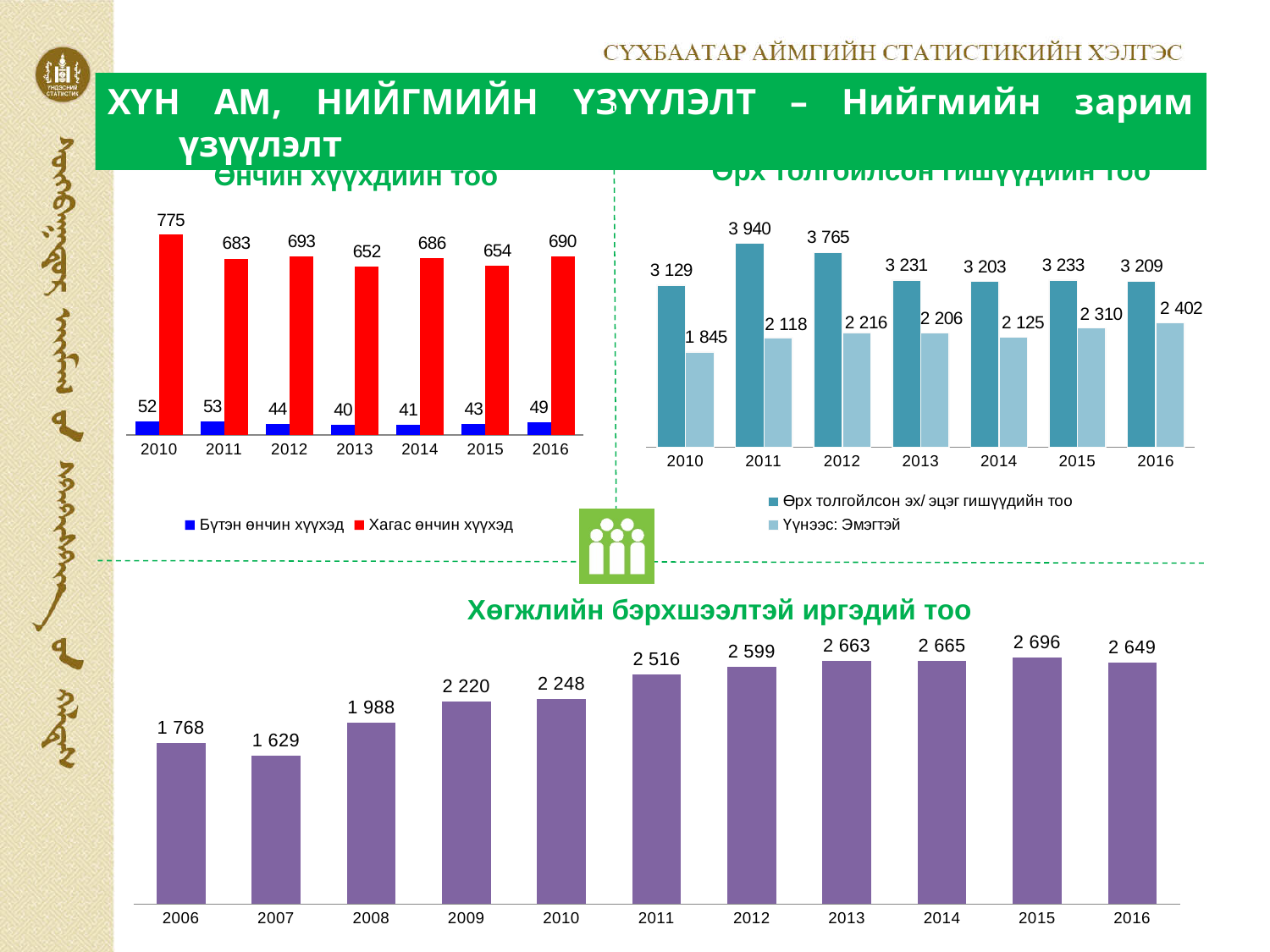
In the top-right chart, what is the value of 'Үүнээс: Эмэгтэй' for 2016? 2 402 In the top-left chart, which year has the lowest value for 'Бүтэн өнчин хүүхэд'? 2013 In the top-left chart, what is the value of 'Хагас өнчин хүүхэд' for 2010? 775 In the top-right chart, which year has the highest value for 'Өрх толгойлсон эх/ эцэг гишүүдийн тоо'? 2011 In the bottom chart titled 'Хөгжлийн бэрхшээлтэй иргэдий тоо', which year has the highest value? 2015 In the top-left chart, what is the value of 'Бүтэн өнчин хүүхэд' for 2013? 40 In the bottom chart titled 'Хөгжлийн бэрхшээлтэй иргэдий тоо', how many years are shown on the x axis? 11 In the bottom chart titled 'Хөгжлийн бэрхшээлтэй иргэдий тоо', which year has the lowest value? 2007 In the bottom chart titled 'Хөгжлийн бэрхшээлтэй иргэдий тоо', what is the difference between the values for 2015 and 2016? 47 In the bottom chart titled 'Хөгжлийн бэрхшээлтэй иргэдий тоо', what is the value for 2016? 2 649 In the top-left chart, how many series does the legend list? 2 What kind of chart is the bottom chart titled 'Хөгжлийн бэрхшээлтэй иргэдий тоо'? Bar chart